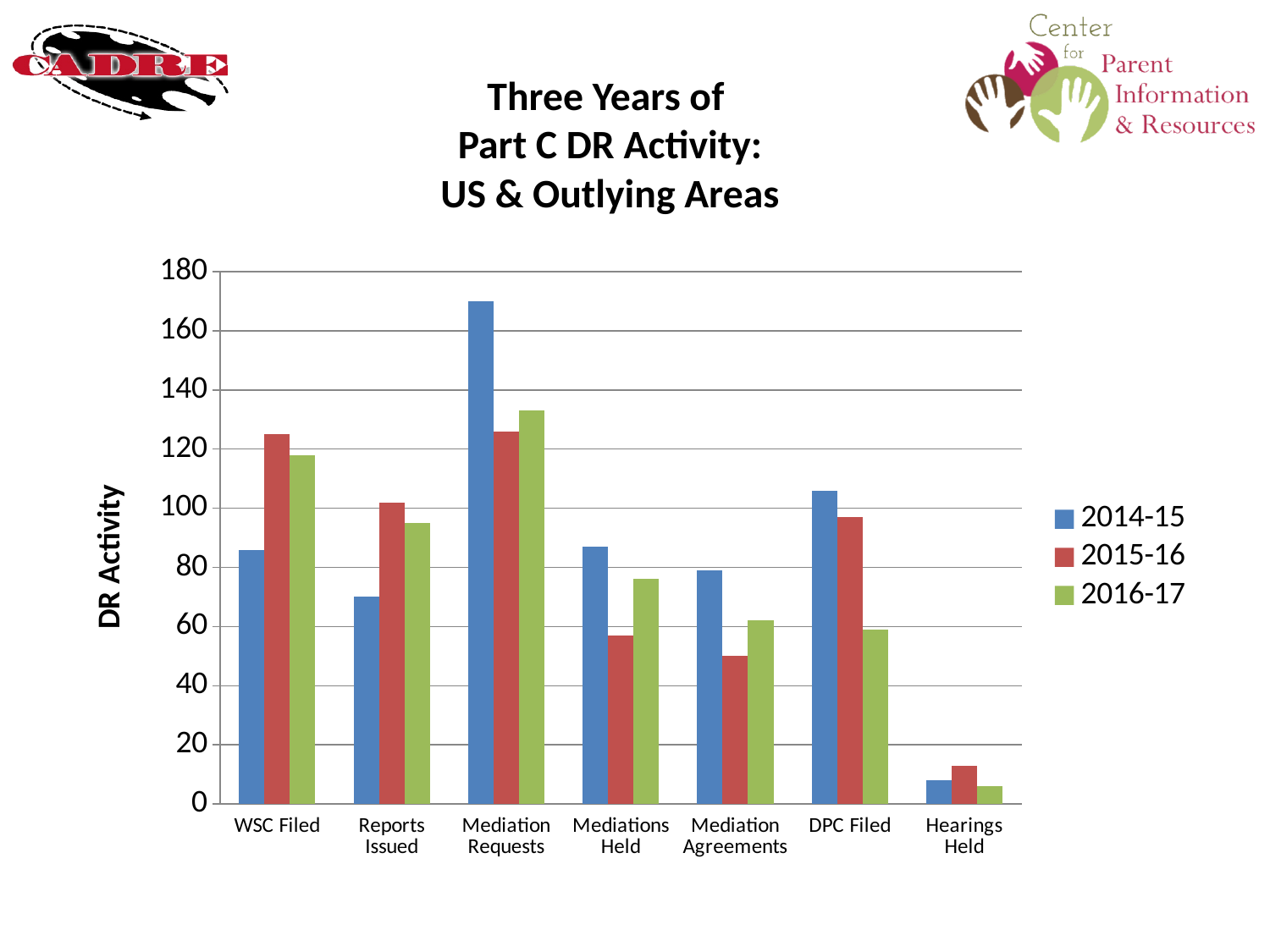
Is the 2016-17 value for DPC Filed greater or less than 80? less Do the DPC Filed values rise or fall from 2014-15 to 2016-17? fall What is the title of the vertical axis? DR Activity Which category has the highest value for 2014-15? Mediation Requests For WSC Filed, which is larger: the 2014-15 value or the 2015-16 value? 2015-16 How many categories are shown along the x axis? 7 For Mediations Held, which is larger: the 2015-16 value or the 2016-17 value? 2016-17 Is the 2015-16 value for Reports Issued greater or less than 80? greater Which category has the lowest value for 2015-16? Hearings Held How many series does the legend list? 3 What kind of chart is shown on the slide? bar chart Is the 2014-15 value for Mediation Requests greater or less than 160? greater